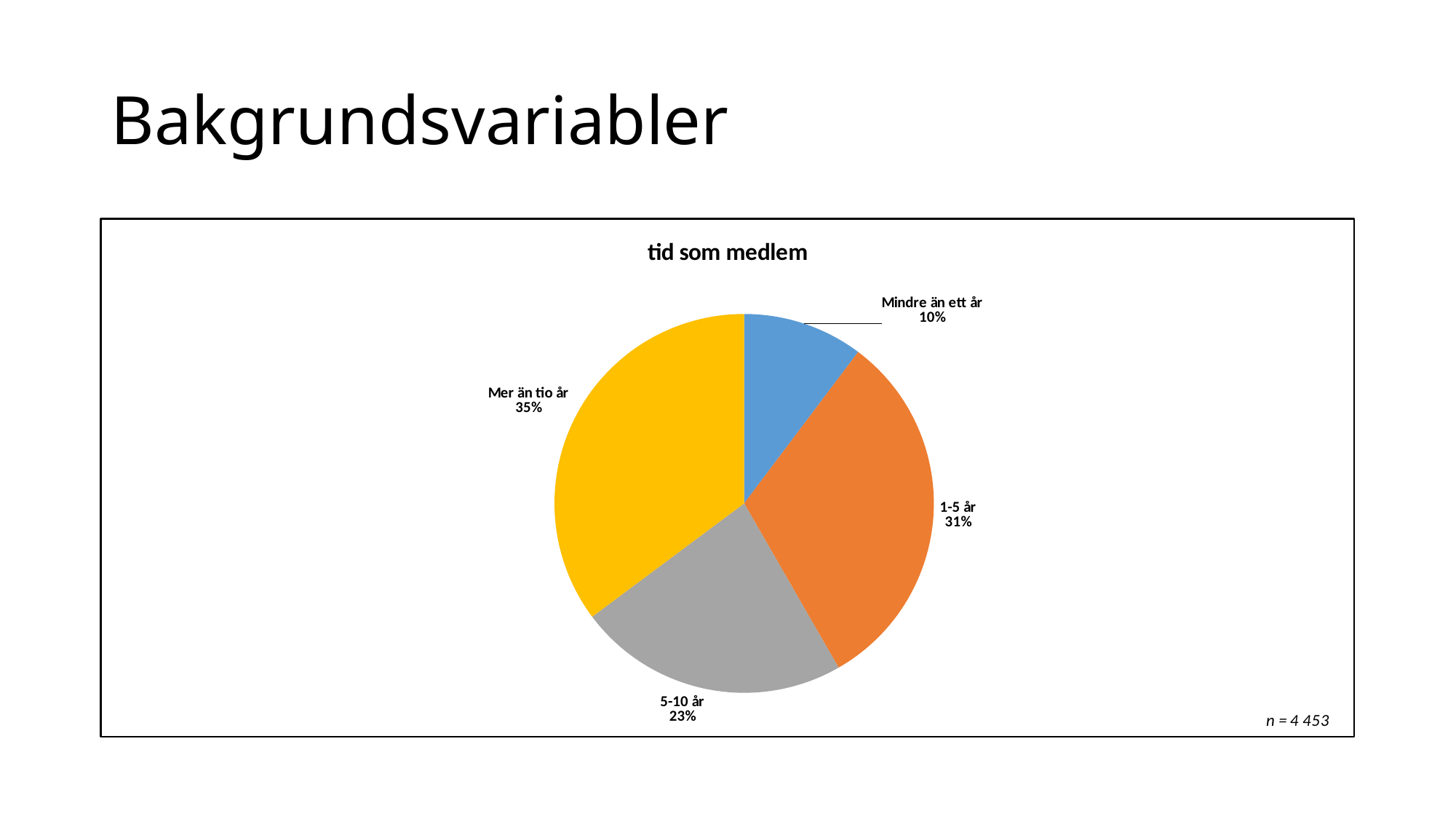
What share of the pie is '1-5 år'? 31% Which is larger, the share for '1-5 år' or the share for '5-10 år'? 1-5 år What kind of chart is shown on the slide? pie chart What sample size (n) is shown on the slide? n = 4 453 Which category has the largest slice of the pie? Mer än tio år What is the difference in percentage points between 'Mer än tio år' and '5-10 år'? 12 What is the title of the chart? tid som medlem What share of the pie is 'Mindre än ett år'? 10% How many slices does the pie chart have? 4 Which category has the smallest slice of the pie? Mindre än ett år What share of the pie is '5-10 år'? 23% What share of the pie is 'Mer än tio år'? 35%